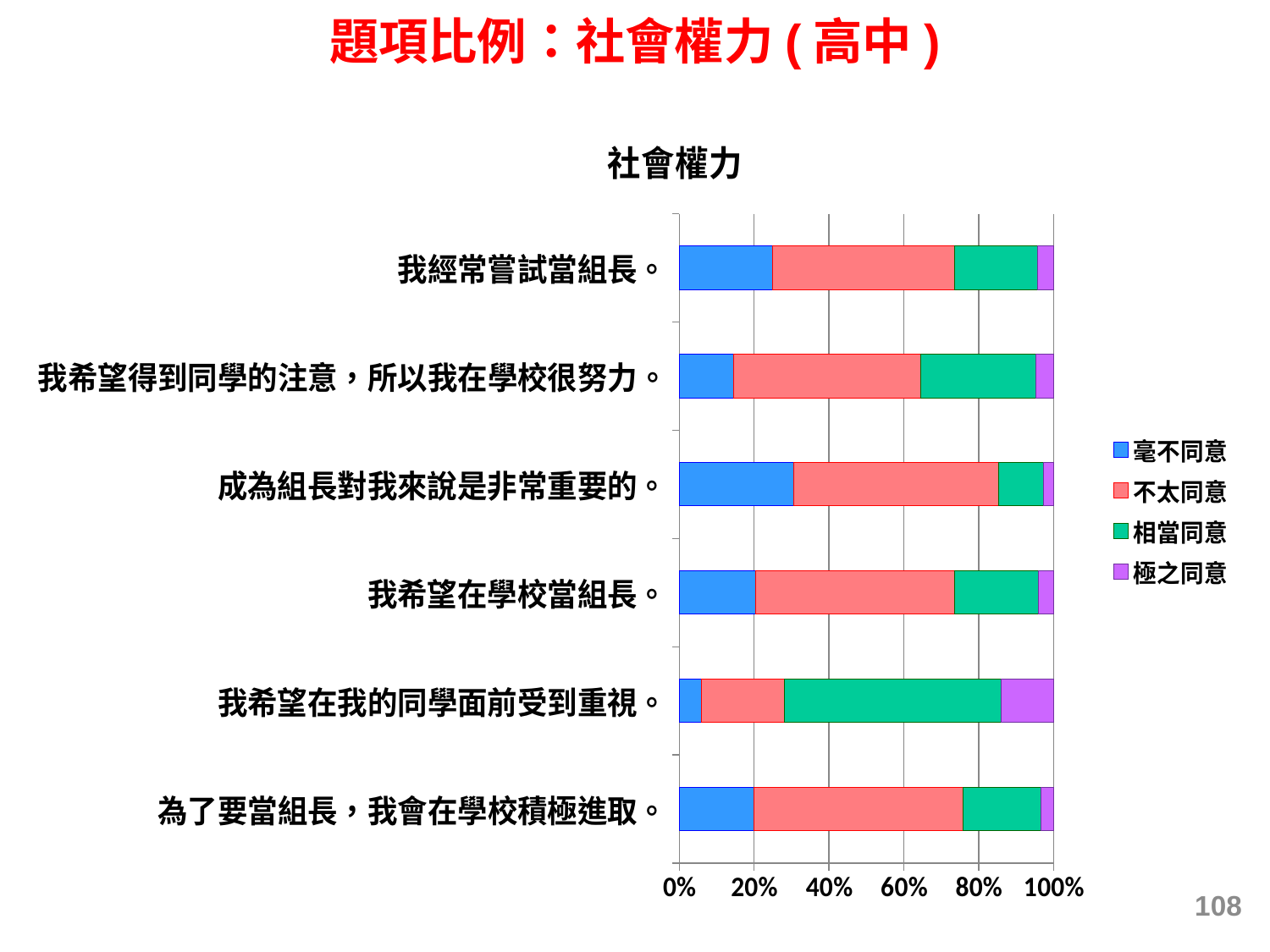
Is the 毫不同意 share for 我希望在我的同學面前受到重視。 greater or less than 20%? less Is the 毫不同意 share for 成為組長對我來說是非常重要的。 greater or less than 20%? greater Which has a larger 不太同意 segment: 成為組長對我來說是非常重要的。 or 我希望在我的同學面前受到重視。? 成為組長對我來說是非常重要的。 How many statements (categories) are plotted in the chart? 6 How many series does the legend list? 4 Which statement has the smallest 毫不同意 segment? 我希望在我的同學面前受到重視。 Which colour represents 相當同意 in the legend? Green What kind of chart is shown on the slide? Stacked bar chart Which statement has the largest 相當同意 segment? 我希望在我的同學面前受到重視。 Is the 相當同意 share for 我希望在我的同學面前受到重視。 greater or less than 40%? greater What is the title of the chart? 社會權力 Which statement has the largest 極之同意 segment? 我希望在我的同學面前受到重視。